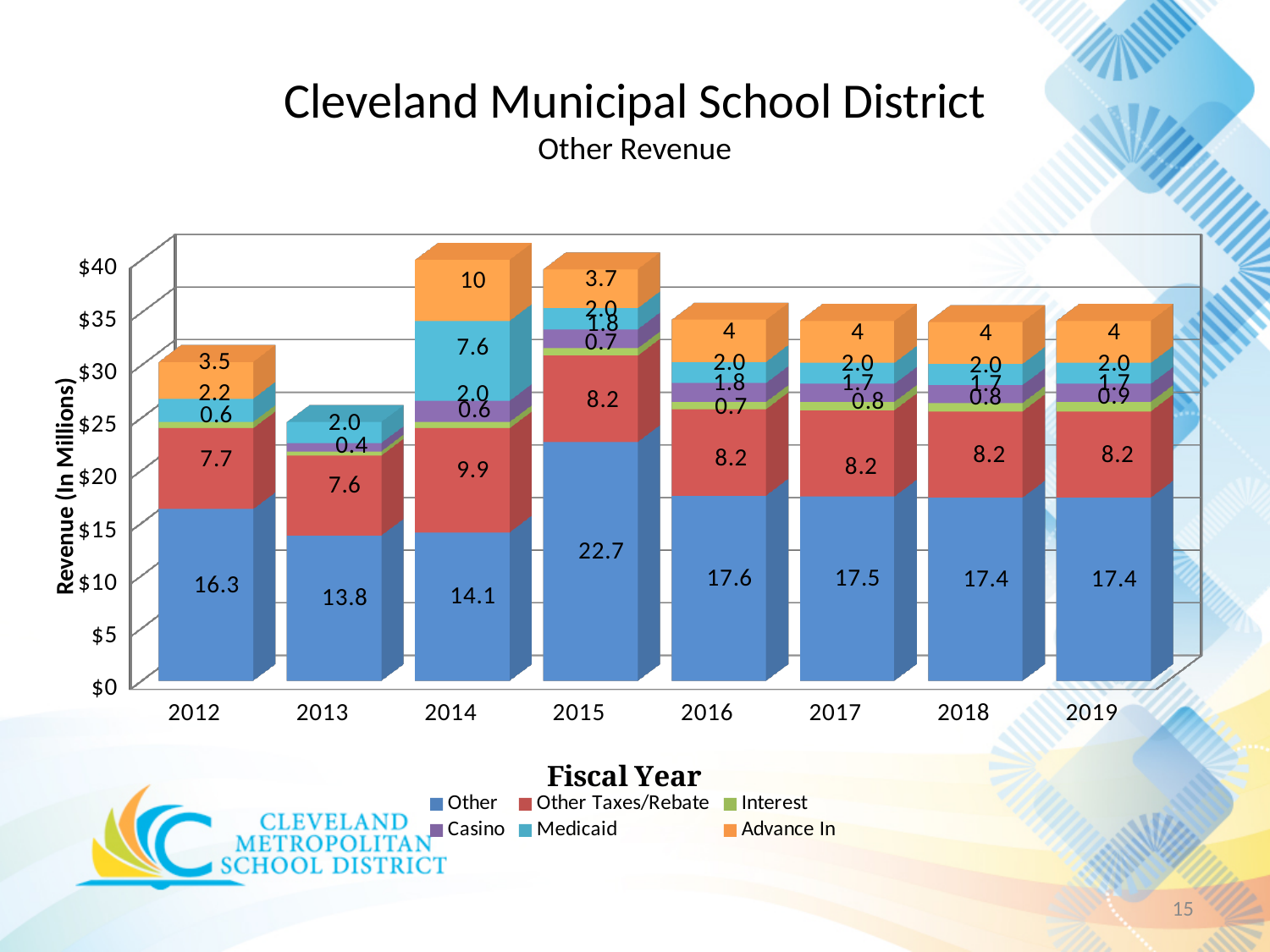
Which fiscal year has the lowest value for the Other series? 2013 Is the total height of the 2014 stacked bar greater or less than $35? greater How many fiscal years are shown on the x axis? 8 How many series does the legend list? 6 What is the difference between the Other values for 2012 and 2013? 2.5 What is the Advance In value for fiscal year 2014? 10 What kind of chart is shown on the slide? Stacked bar chart Which year has the larger Medicaid value, 2014 or 2015? 2014 Which fiscal year has the highest value for the Other series? 2015 What is the total of the stacked bar for fiscal year 2016? 34.3 What is the Other Taxes/Rebate value for fiscal year 2014? 9.9 What is the value of the Other series for fiscal year 2015? 22.7